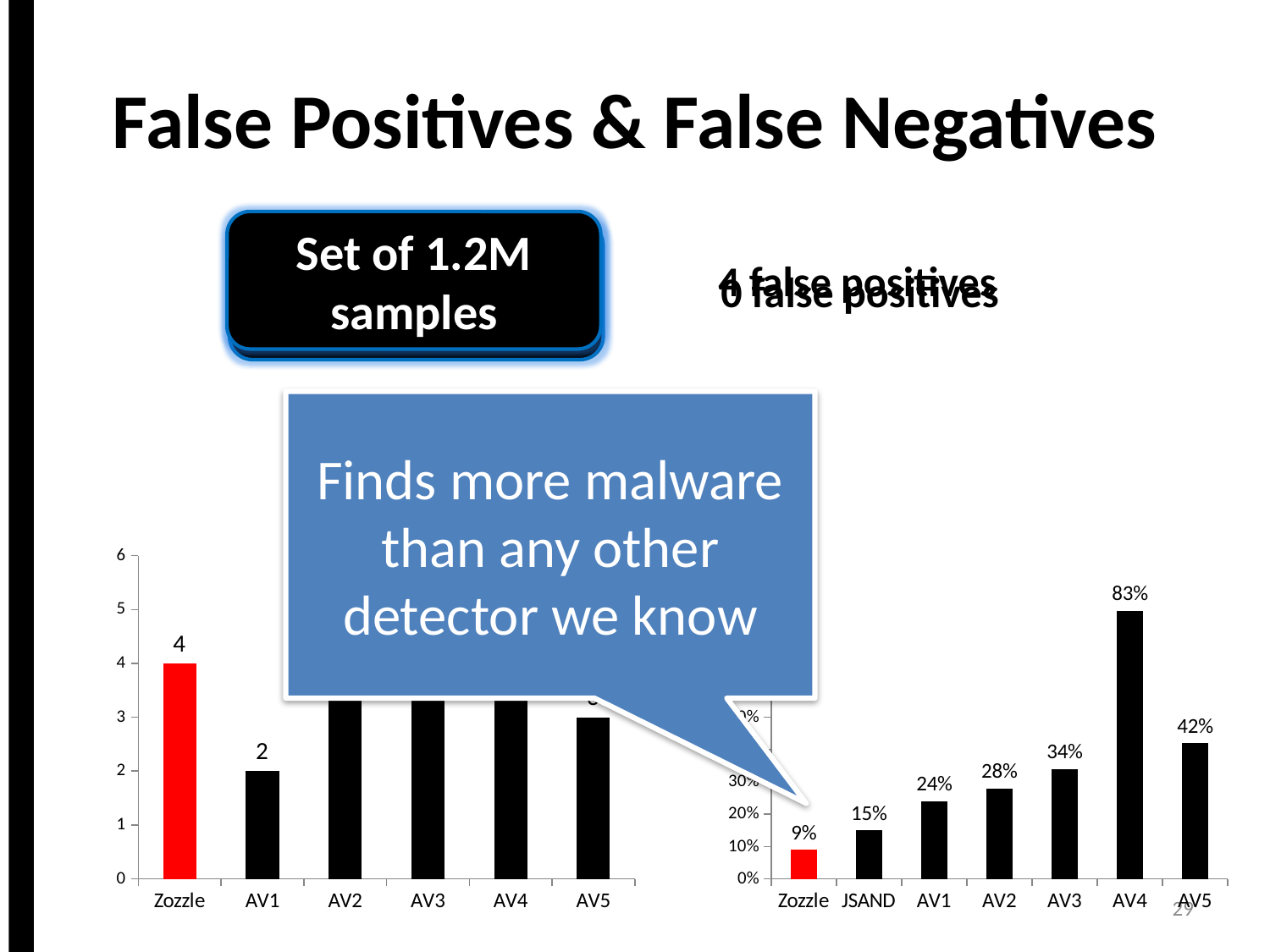
In the right chart, which category has the highest value? AV4 In the left chart, what is the value for AV1? 2 How many categories are shown on the x axis of the left chart? 6 In the left chart, what is the value for Zozzle? 4 In the right chart, what is the difference between the values for AV5 and AV3? 8% In the right chart, what is the value for AV4? 83% What kind of chart is the left chart? bar chart How many categories are shown on the x axis of the right chart? 7 In the right chart, what is the value for JSAND? 15% In the left chart, which has the larger value, Zozzle or AV1? Zozzle In the left chart, what is the difference between the values for Zozzle and AV1? 2 In the right chart, which category has the lowest value? Zozzle